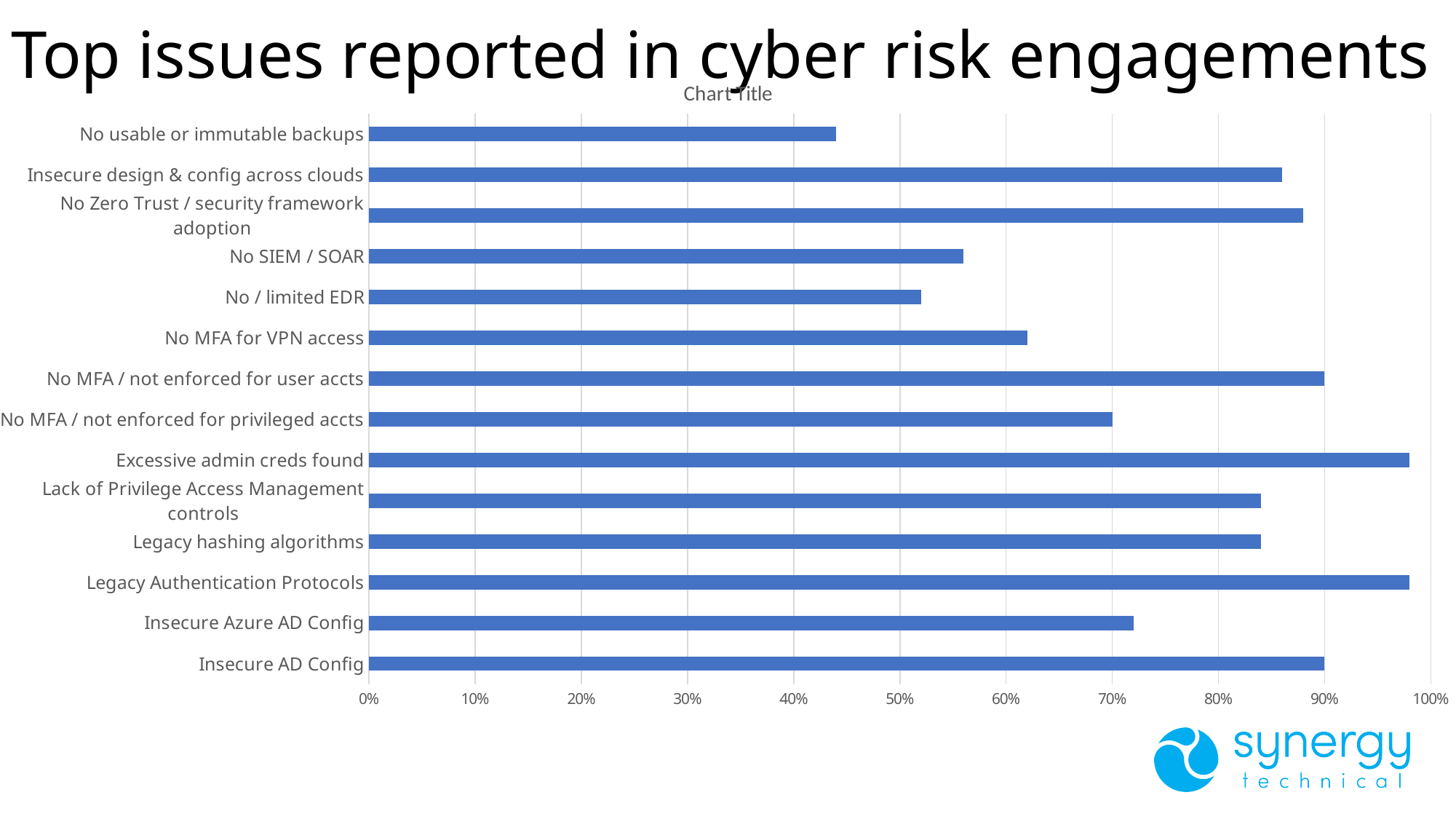
What is the highest value shown on the chart's horizontal axis? 100% Which is larger: the value for "Insecure Azure AD Config" or the value for "Insecure AD Config"? Insecure AD Config How many issue categories are plotted in the chart? 14 Which is larger: the value for "No MFA for VPN access" or the value for "No / limited EDR"? No MFA for VPN access Is the value for "Insecure design & config across clouds" greater or less than 80%? greater What kind of chart is shown on the slide? bar chart Which issue has the lowest value in the chart? No usable or immutable backups Is the value for "Excessive admin creds found" greater or less than 90%? greater What is the value for "No MFA / not enforced for user accts"? 90% What is the value for "Insecure AD Config"? 90% What is the value for "No MFA / not enforced for privileged accts"? 70% Is the value for "No usable or immutable backups" greater or less than 50%? less